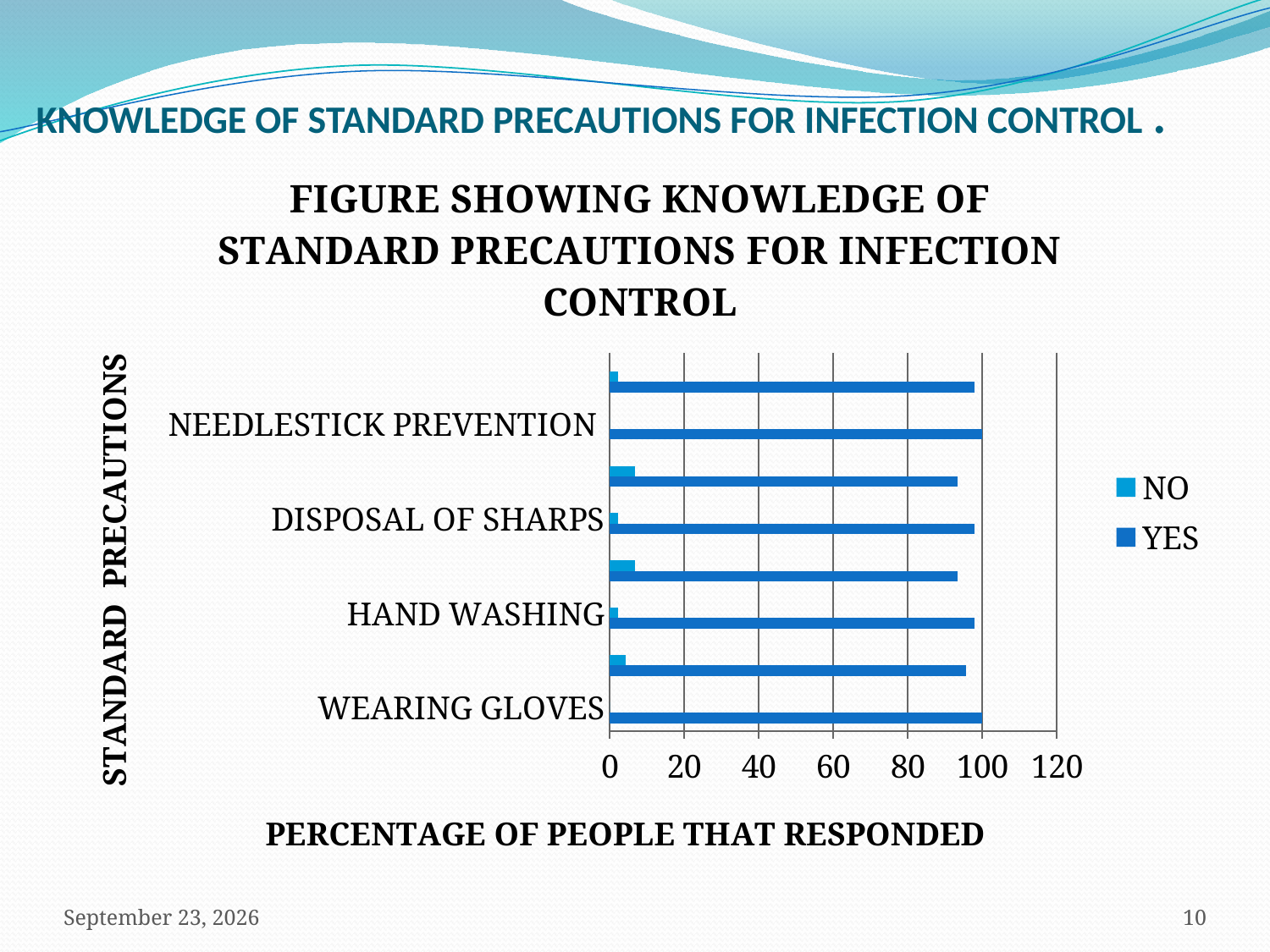
What is the highest tick value shown on the chart's horizontal axis? 120 Is the NO value for HAND WASHING greater or less than 20? less What kind of chart is shown on the slide? bar chart How many series does the chart's legend list? 2 Is the NO value for DISPOSAL OF SHARPS greater or less than 20? less Is the YES value for NEEDLESTICK PREVENTION greater or less than 80? greater What are the two series named in the chart's legend? NO and YES For WEARING GLOVES, which series has the larger value, YES or NO? YES What is the title of the chart's horizontal axis? PERCENTAGE OF PEOPLE THAT RESPONDED For DISPOSAL OF SHARPS, which series has the larger value, YES or NO? YES